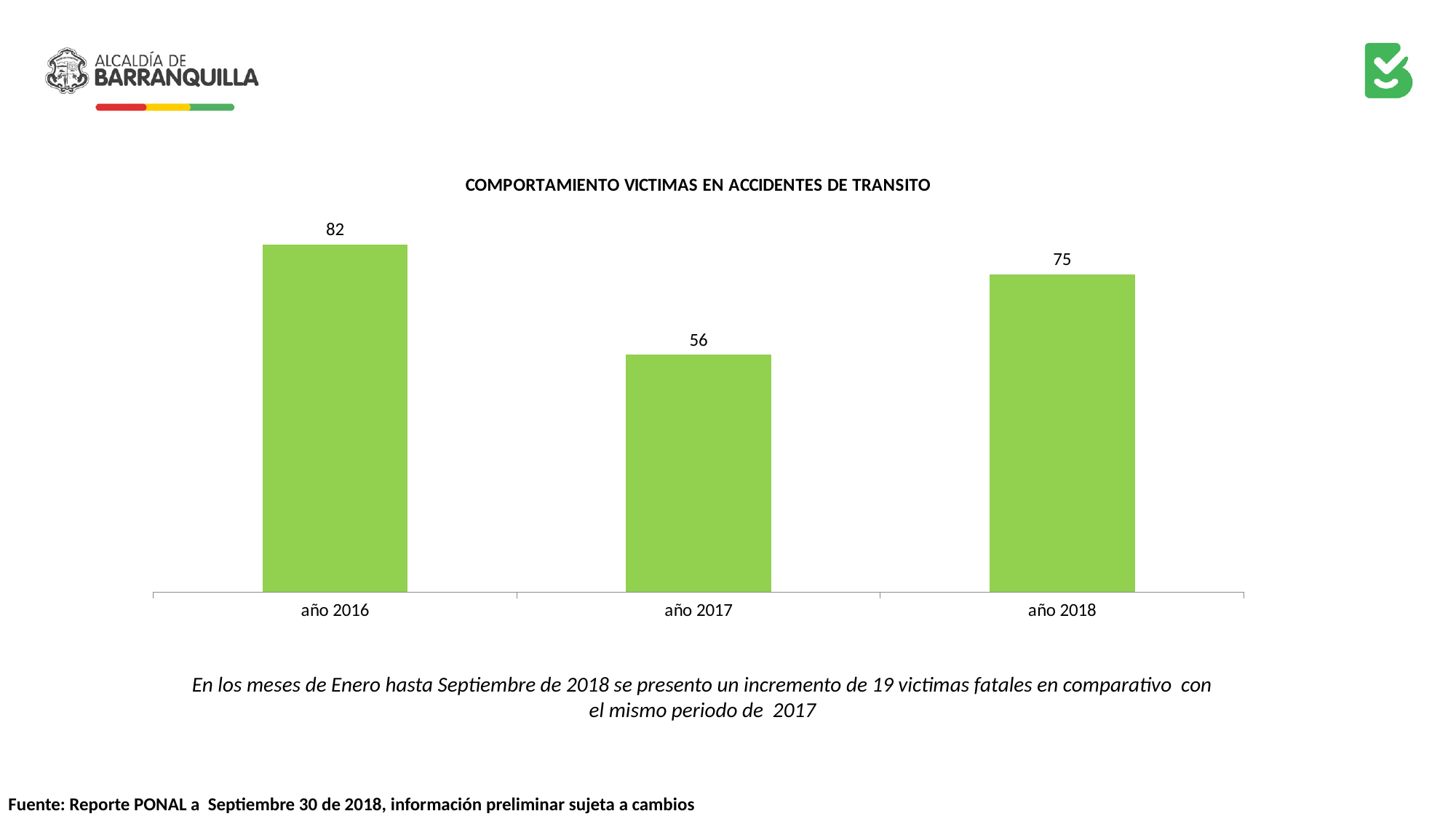
How many years are shown on the chart? 3 Which is larger, the value for año 2018 or the value for año 2017? año 2018 What kind of chart is shown on the slide? bar chart What is the value for año 2018? 75 What is the title of the chart? COMPORTAMIENTO VICTIMAS EN ACCIDENTES DE TRANSITO Does the value rise or fall from año 2016 to año 2017? fall What is the difference between the values for año 2018 and año 2017? 19 Which year has the highest value? año 2016 Which year has the lowest value? año 2017 What is the difference between the values for año 2016 and año 2017? 26 What is the value for año 2017? 56 What is the value for año 2016? 82